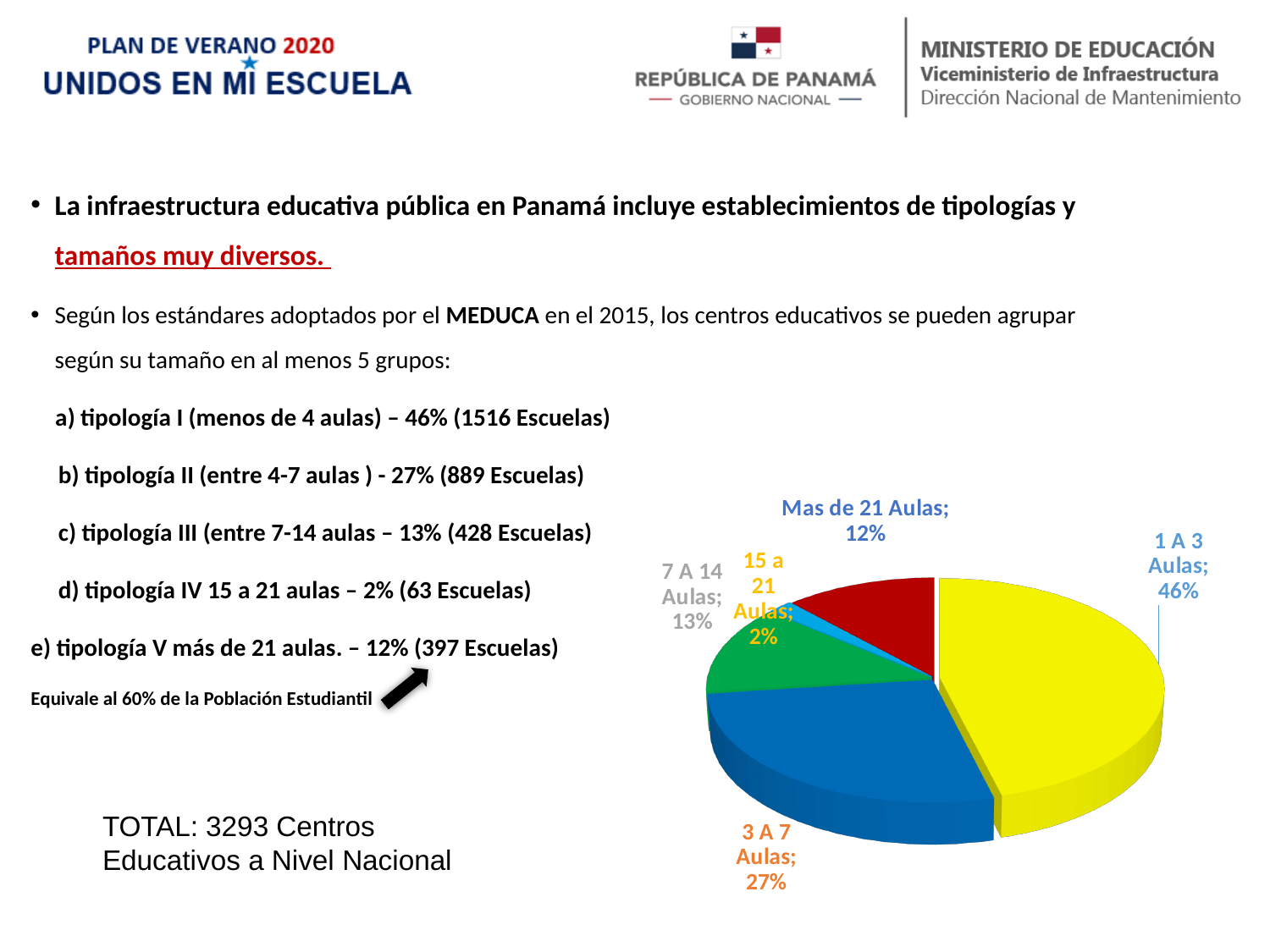
What is the difference in percentage points between the "1 A 3 Aulas" slice and the "3 A 7 Aulas" slice? 19 What colour is the "1 A 3 Aulas" slice in the pie chart? yellow What share of the pie does the "1 A 3 Aulas" slice represent? 46% What is the value shown for "7 A 14 Aulas" in the pie chart? 13% How many slices does the pie chart have? 5 Which is larger in the pie chart, "7 A 14 Aulas" or "Mas de 21 Aulas"? 7 A 14 Aulas Which slice of the pie chart is the largest? 1 A 3 Aulas What is the value shown for "Mas de 21 Aulas" in the pie chart? 12% What is the value shown for "3 A 7 Aulas" in the pie chart? 27% What kind of chart is shown on the slide? pie chart What is the value shown for "15 a 21 Aulas" in the pie chart? 2% Which slice of the pie chart is the smallest? 15 a 21 Aulas